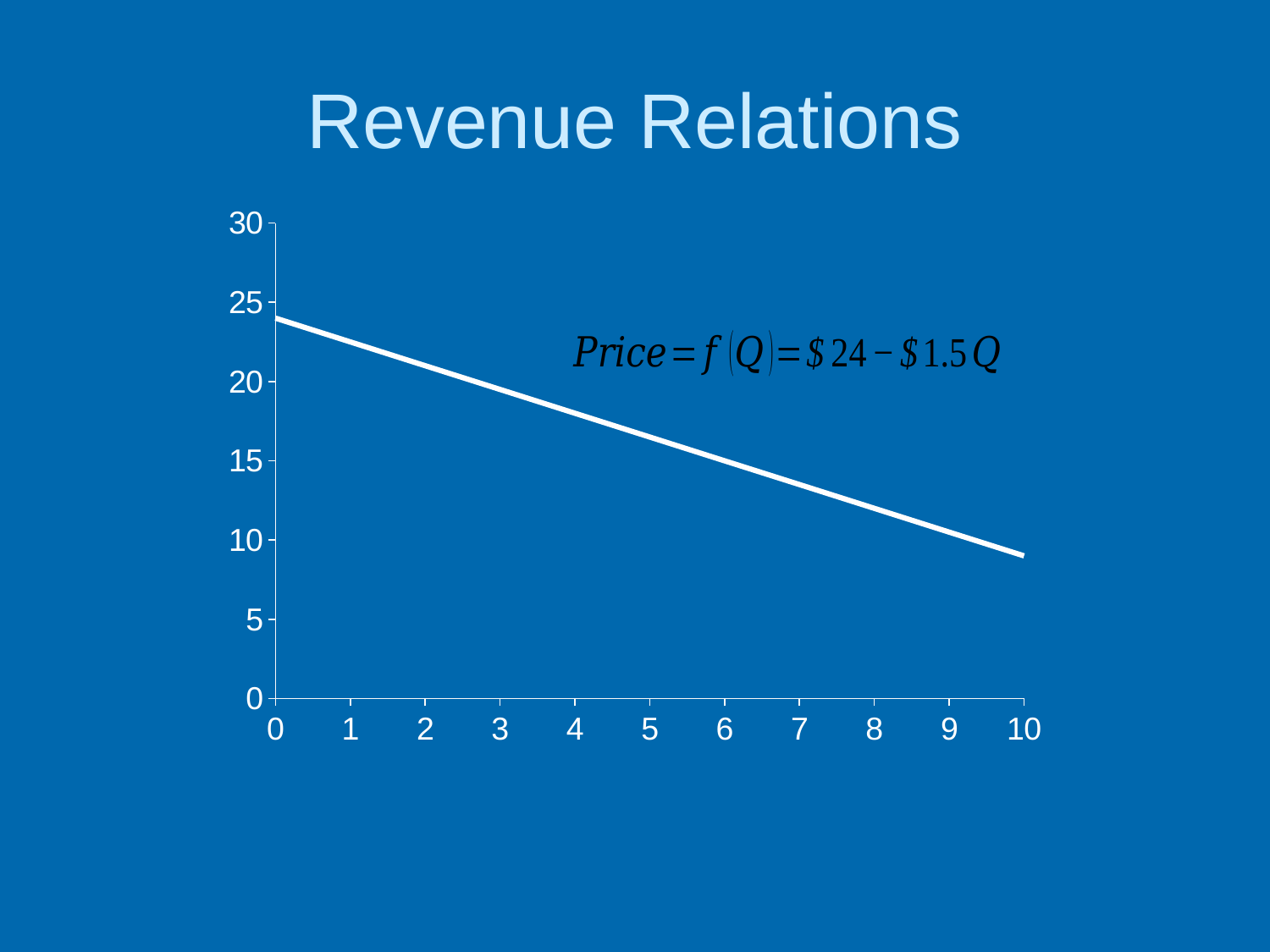
How many tick labels are shown on the x axis? 11 Is the value of the line at Q = 10 greater or less than 15? less Is the value of the line at Q = 8 greater or less than 15? less Is the value of the line at Q = 2 greater or less than 25? less What equation is printed next to the line on the chart? Price = f(Q) = $24 − $1.5Q What kind of chart is shown on the slide? line chart At which value of Q is the plotted price highest? 0 Which is larger, the value of the line at Q = 2 or at Q = 8? Q = 2 Does the plotted line rise or fall as Q increases along the x axis? fall At which value of Q is the plotted price lowest? 10